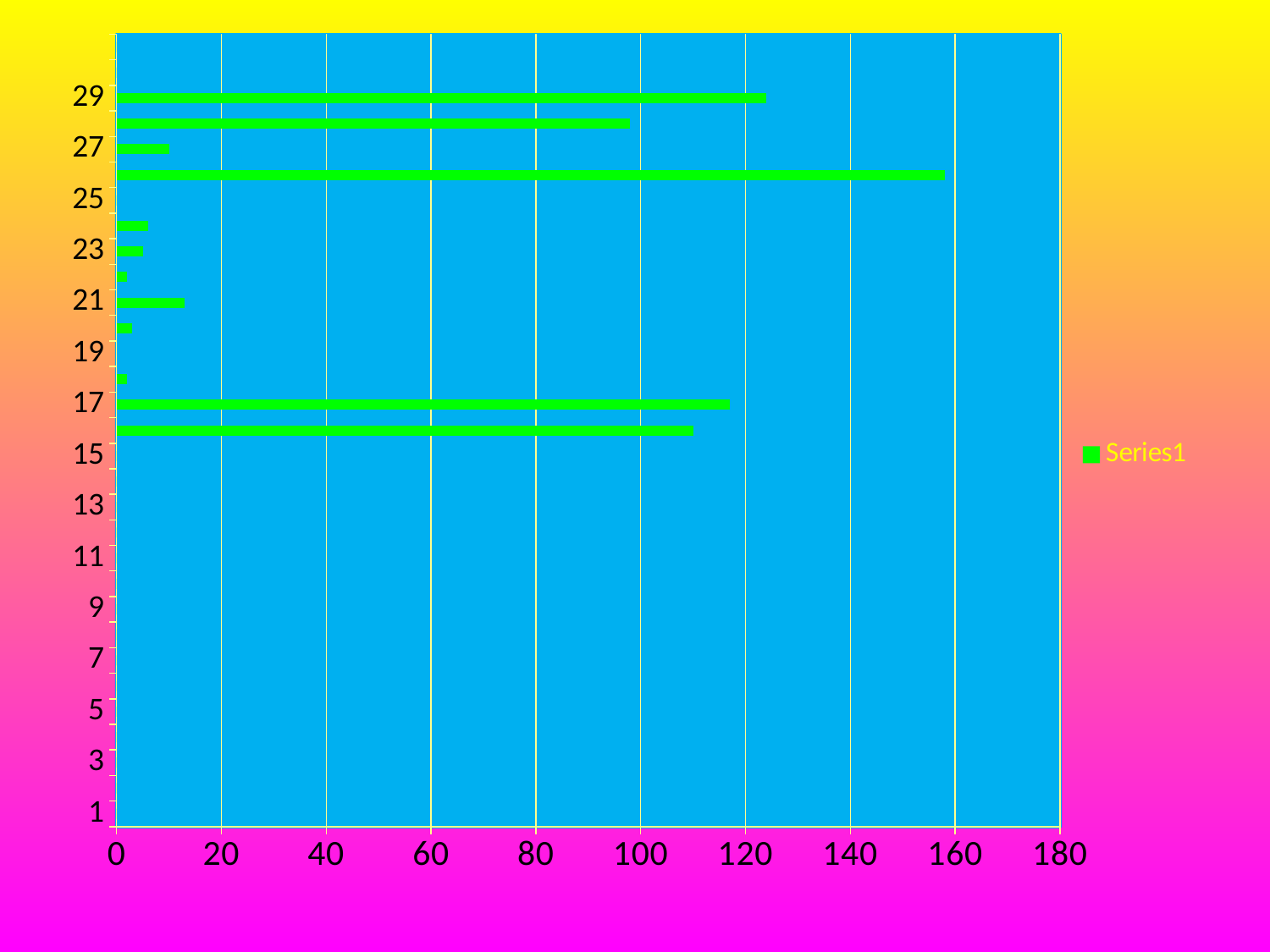
Which has the larger value, category 29 or category 27? 29 What is the name of the series shown in the legend? Series1 What kind of chart is shown on the slide? bar chart Is the value for category 21 greater or less than 20? less Is the value for category 27 greater or less than 20? less Is the value for category 29 greater or less than 100? greater How many series does the legend list? 1 What colour are the bars in the chart? green Which has the larger value, category 21 or category 23? 21